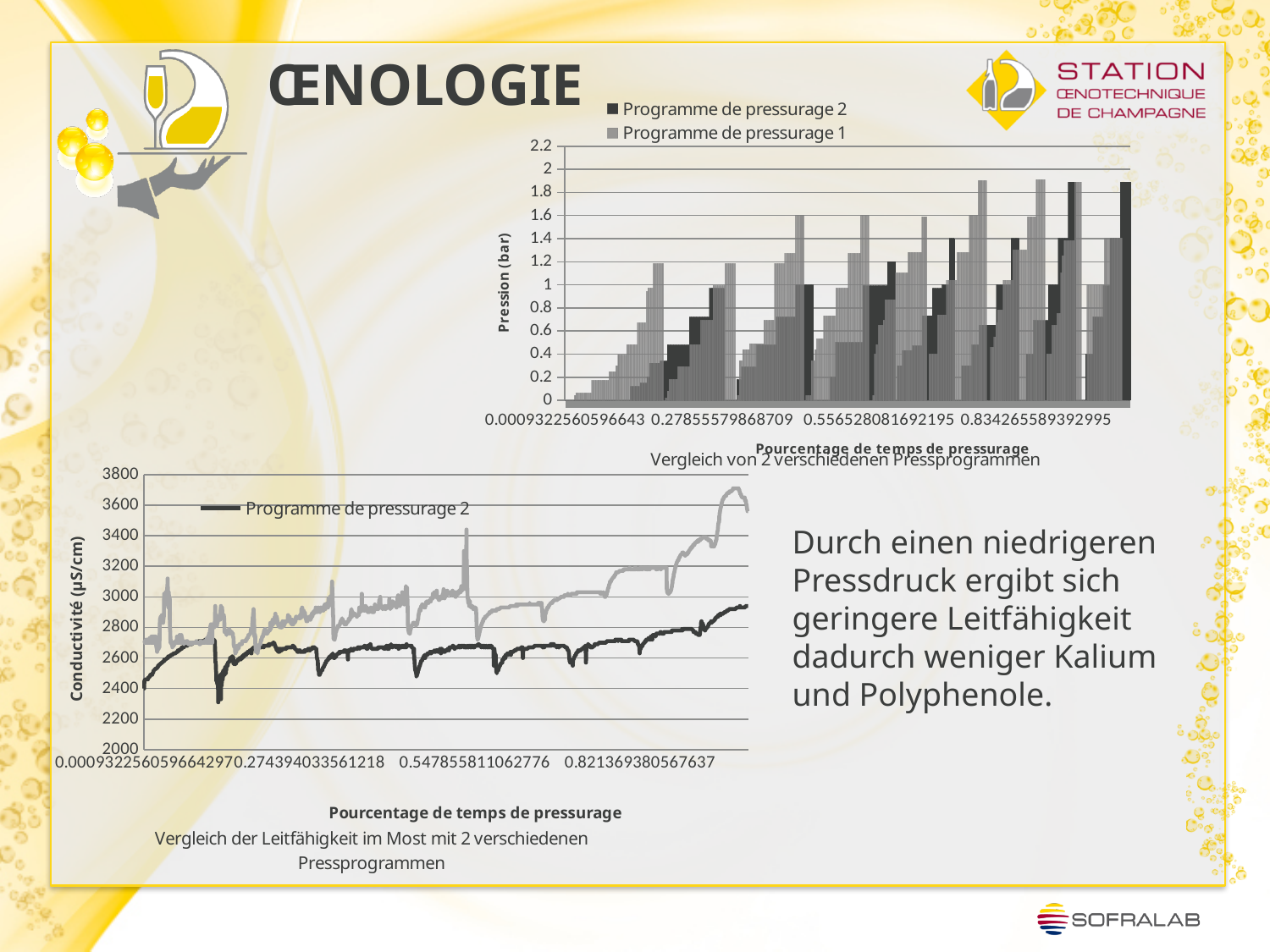
What kind of chart is the top chart on the slide (the one with the y-axis 'Pression (bar)')? bar chart In the bottom chart (Conductivité (µS/cm)), is the highest point of the dark line for Programme de pressurage 2 greater or less than 3200? less In the bottom chart (Conductivité (µS/cm)), is the highest point of the light grey line greater or less than 3600? greater In the bottom chart (Conductivité (µS/cm)), does the dark line for Programme de pressurage 2 rise or fall overall from left to right? rise In the top chart (Pression (bar)), what are the two series named in the legend? Programme de pressurage 2 and Programme de pressurage 1 In the top chart (Pression (bar)), is the highest bar greater or less than 2? less In the top chart (Pression (bar)), how many series does the legend list? 2 What kind of chart is the bottom chart on the slide (the one with the y-axis 'Conductivité (µS/cm)')? line chart In the bottom chart (Conductivité (µS/cm)), at the right end of the x axis, is the dark line for Programme de pressurage 2 above or below the light grey line? below In the bottom chart (Conductivité (µS/cm)), what is the title of the x axis? Pourcentage de temps de pressurage